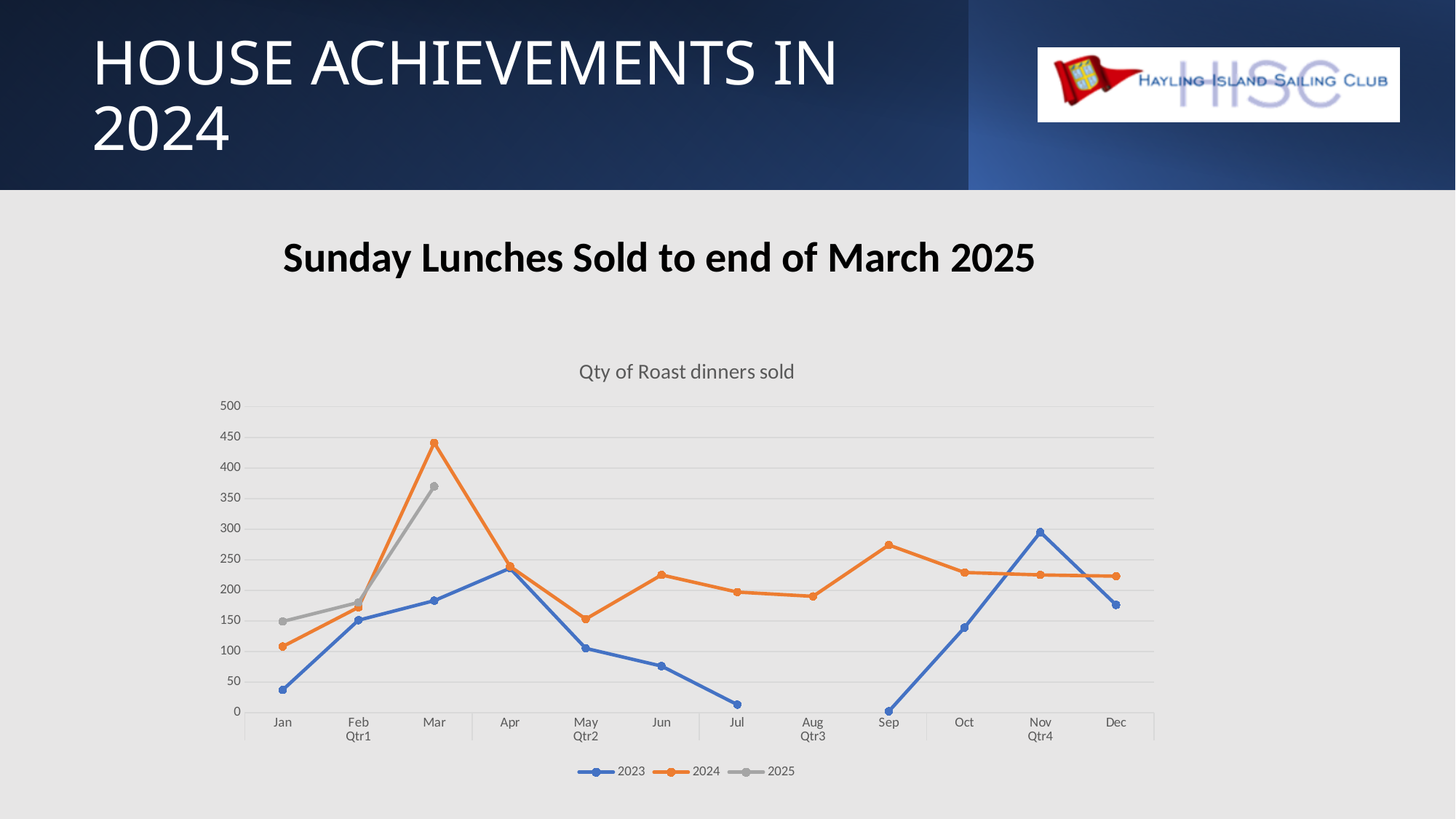
Which series has the larger value in Nov, 2023 or 2024? 2023 Is the value for 2024 in Mar greater or less than 400? greater In which month does the 2024 series reach its highest value? Mar Is the value for 2025 in Mar greater or less than 350? greater How many months are shown along the x axis? 12 Is the value for 2024 in Jan greater or less than 150? less Does the 2025 series rise or fall from Jan to Mar? rise In which month does the 2023 series reach its highest value? Nov How many series does the legend list? 3 What is the title printed above the chart's plot area? Qty of Roast dinners sold What kind of chart is shown on the slide? line chart